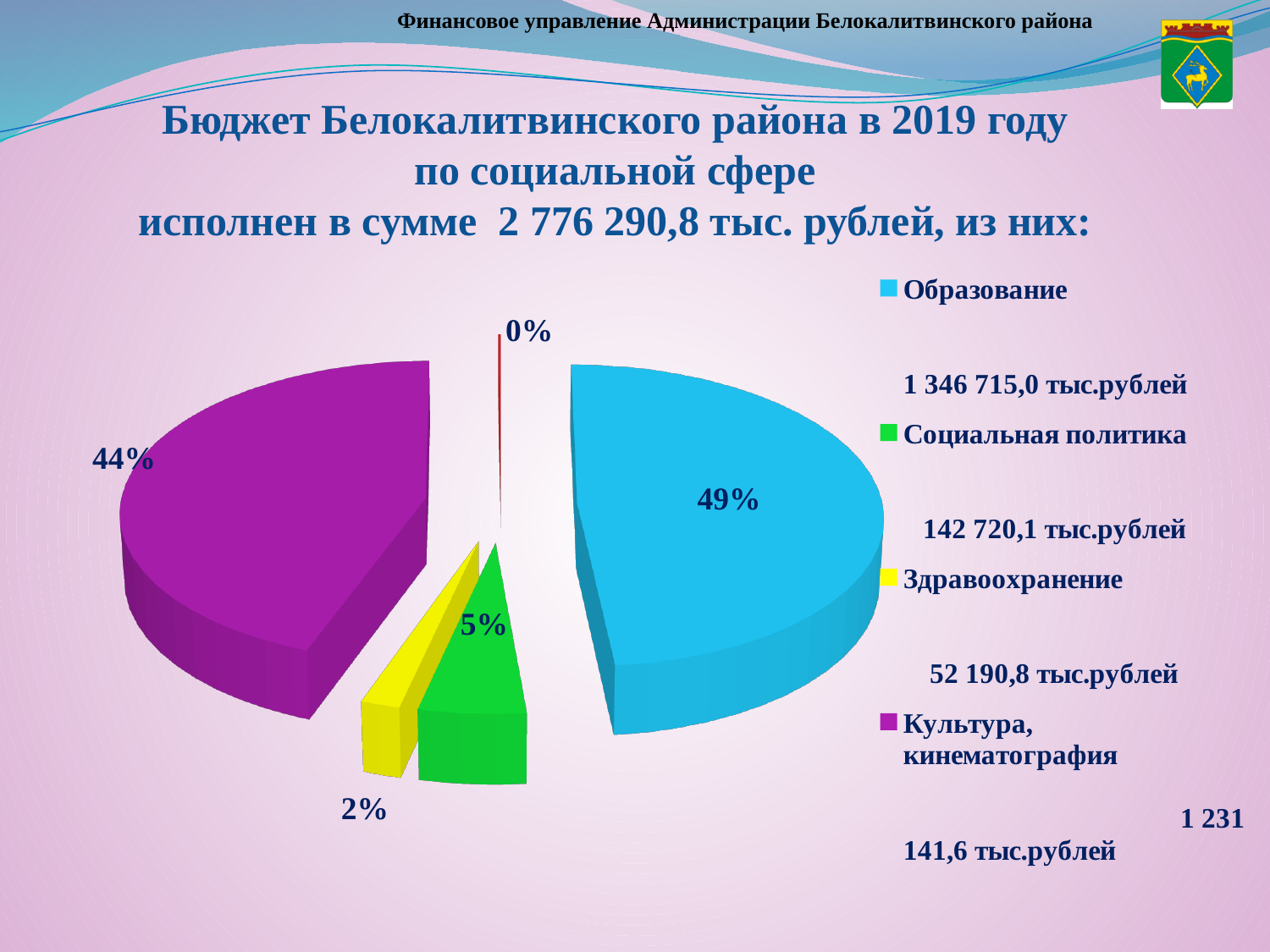
By how many percentage points does the share for Образование exceed the share for Культура, кинематография? 5 percentage points How many categories does the legend list? 4 What amount in тыс.рублей is shown in the legend for Образование? 1 346 715,0 тыс.рублей What kind of chart is shown on the slide? Pie chart Which is larger, the share for Образование or the share for Культура, кинематография? Образование What share of the pie does Социальная политика have? 5% What share of the pie does Культура, кинематография have? 44% What amount in тыс.рублей is shown in the legend for Здравоохранение? 52 190,8 тыс.рублей Which category has the largest slice of the pie? Образование What share of the pie does Образование have? 49% What share of the pie does Здравоохранение have? 2% Of the four categories listed in the legend, which has the smallest share? Здравоохранение